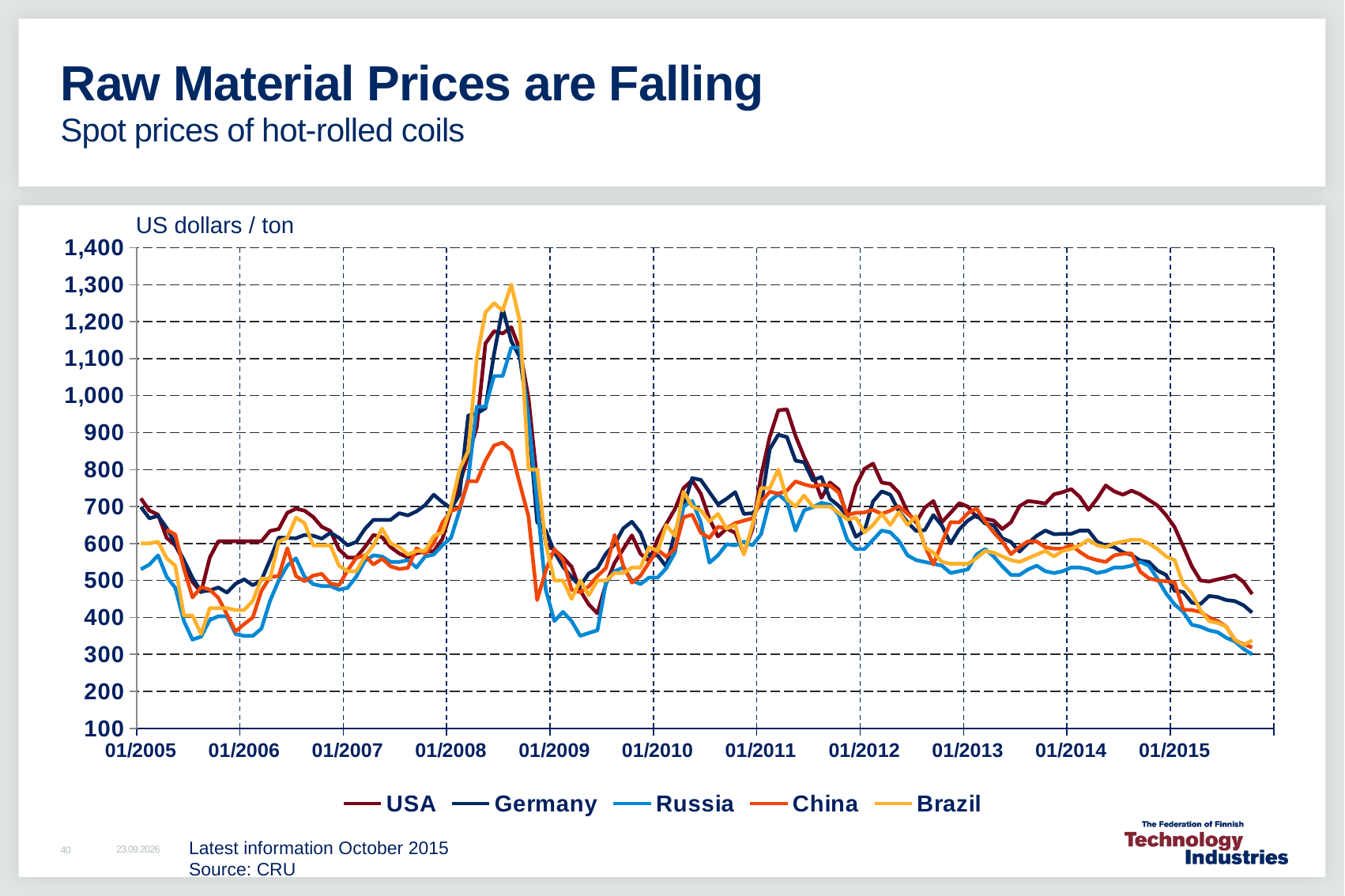
Which countries are listed in the chart legend? USA, Germany, Russia, China, Brazil Which series has the lowest peak during the 2008 price spike? China Do the prices rise or fall from 01/2014 to the end of the series? fall How many series does the legend list? 5 Is the peak value for Brazil in 2008 greater or less than 1,200? greater Is the value for Russia at 01/2005 greater or less than 600? less Is the value for Russia at the end of the series greater or less than 400? less Which series reaches the highest peak in 2008? Brazil At 01/2011, which is higher, the USA line or the Russia line? USA What unit is shown on the y axis of the chart? US dollars / ton What kind of chart is shown on the slide? Line chart